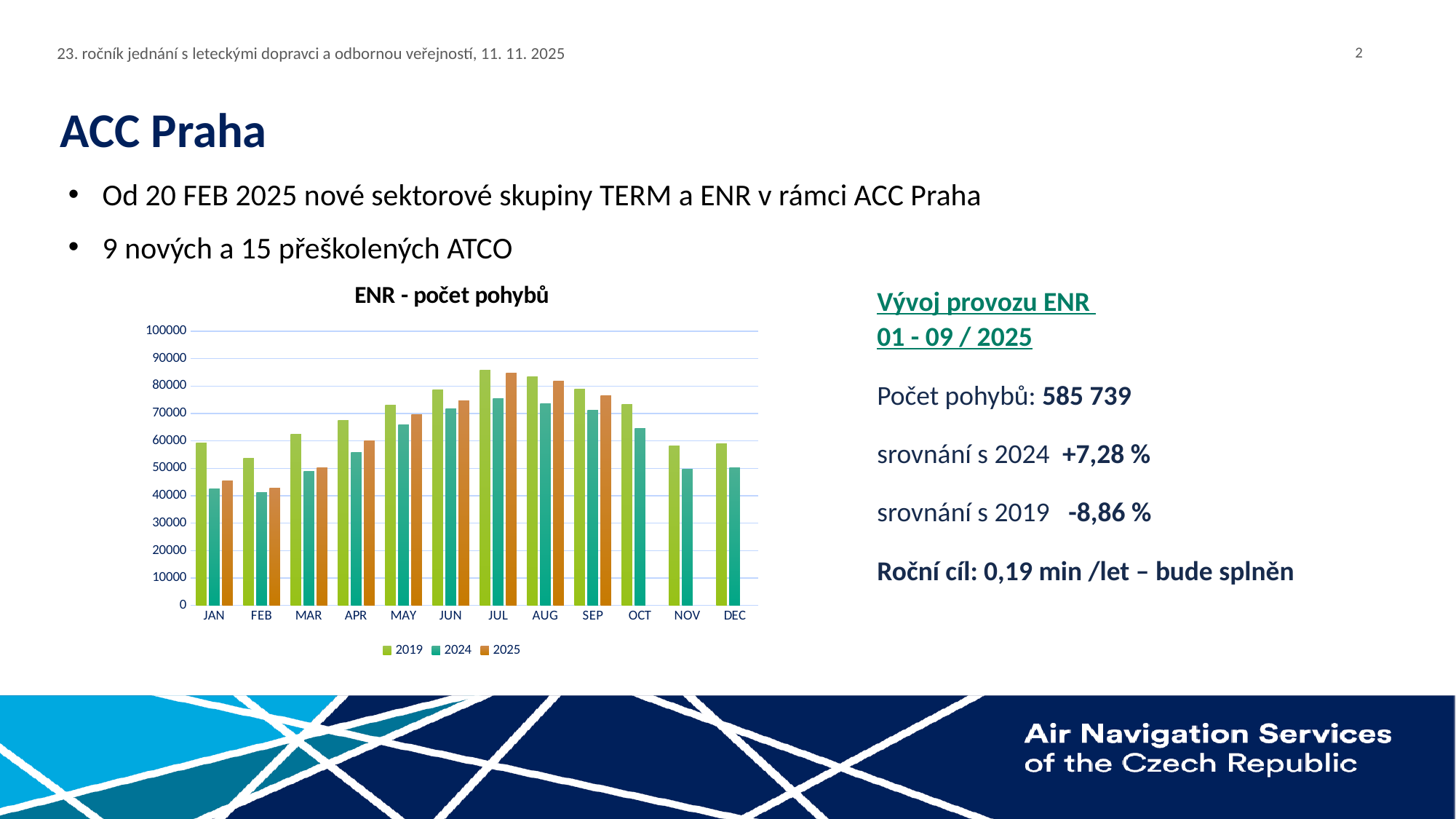
Is the value for 2024 in JAN greater or less than 50000? less How many series does the chart's legend list? 3 In AUG, which series has the larger value, 2024 or 2025? 2025 For how many months does the chart show a bar for the 2025 series? 9 Is the value for 2019 in JUL greater or less than 80000? greater What kind of chart is shown on the slide? bar chart In which month is the 2019 series highest? JUL Is the value for 2025 in SEP greater or less than 70000? greater In which month is the 2025 series highest? JUL What is the title of the chart? ENR - počet pohybů How many months are shown on the x axis of the chart? 12 Do the 2019 values rise or fall from JAN to JUL? rise